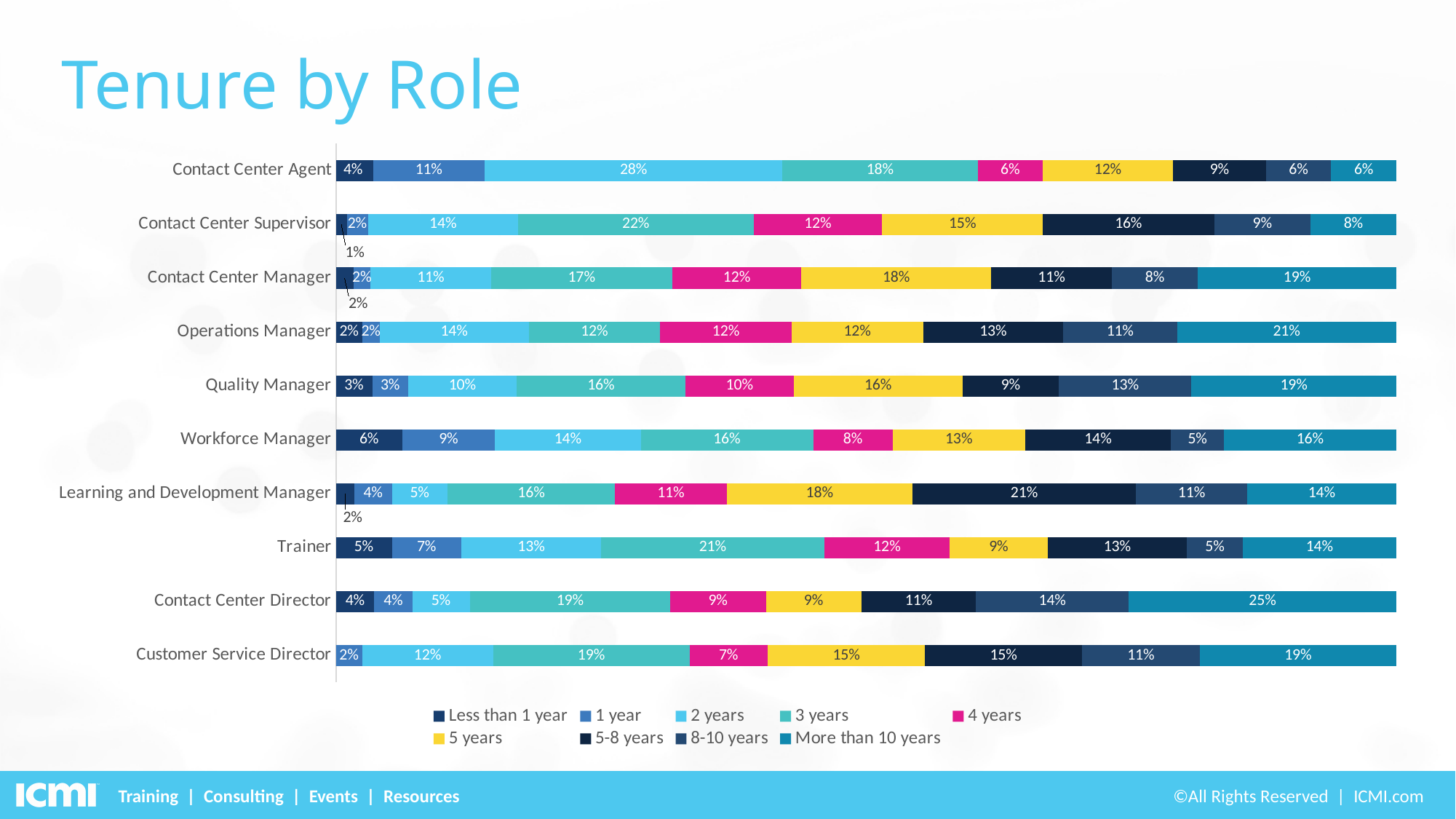
What kind of chart is shown on the slide? Stacked bar chart What percentage of Contact Center Directors have more than 10 years of tenure? 25% How many roles are plotted on the chart? 10 What percentage of Learning and Development Managers have 5-8 years of tenure? 21% Which role has the highest share of people with 2 years of tenure? Contact Center Agent What is the difference between the 3 years share for Contact Center Supervisor and for Operations Manager? 10% How many tenure series does the legend list? 9 Which role has the highest share of people with more than 10 years of tenure? Contact Center Director Which is larger: the 5 years share for Contact Center Manager or for Trainer? Contact Center Manager What percentage of Contact Center Supervisors have less than 1 year of tenure? 1% What is the title of the chart? Tenure by Role What percentage of Contact Center Agents have 2 years of tenure? 28%